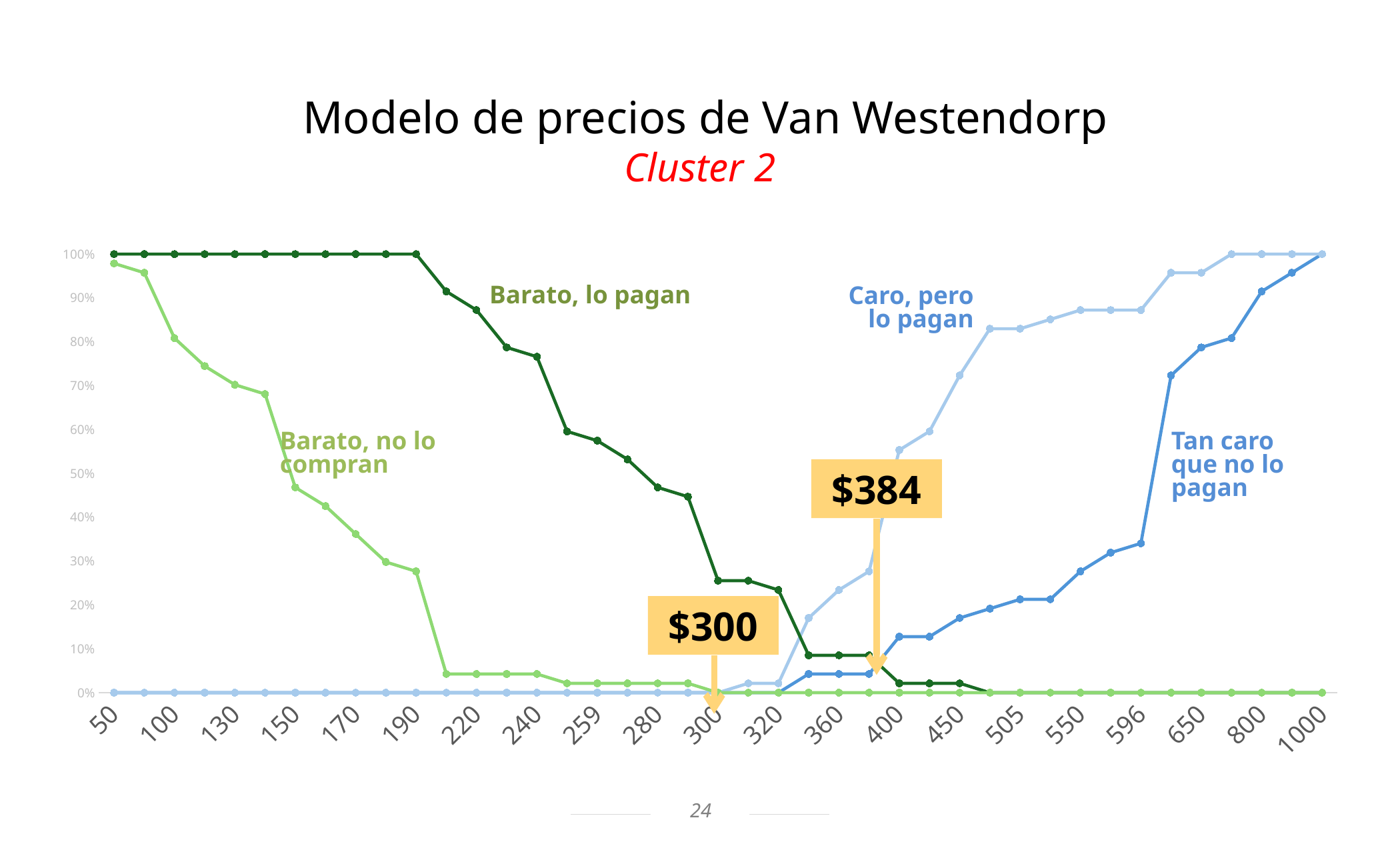
Is the value of 'Barato, no lo compran' at a price of 150 greater or less than 60%? less Is the value of 'Barato, lo pagan' at a price of 240 greater or less than 70%? greater At a price of 650, which series has the larger value: 'Caro, pero lo pagan' or 'Tan caro que no lo pagan'? Caro, pero lo pagan What kind of chart is shown on the slide? Line chart What is the value of the 'Tan caro que no lo pagan' series at a price of 50? 0% Is the value of 'Caro, pero lo pagan' at a price of 450 greater or less than 60%? greater Does the 'Tan caro que no lo pagan' series rise or fall as price increases along the x axis? Rises What is the value of the 'Barato, lo pagan' series at a price of 50? 100% How many data series are plotted on the chart? 4 What is the value of the 'Caro, pero lo pagan' series at a price of 1000? 100% What two price points are highlighted with yellow annotation boxes on the chart? $300 and $384 How many price labels are shown along the x axis? 21